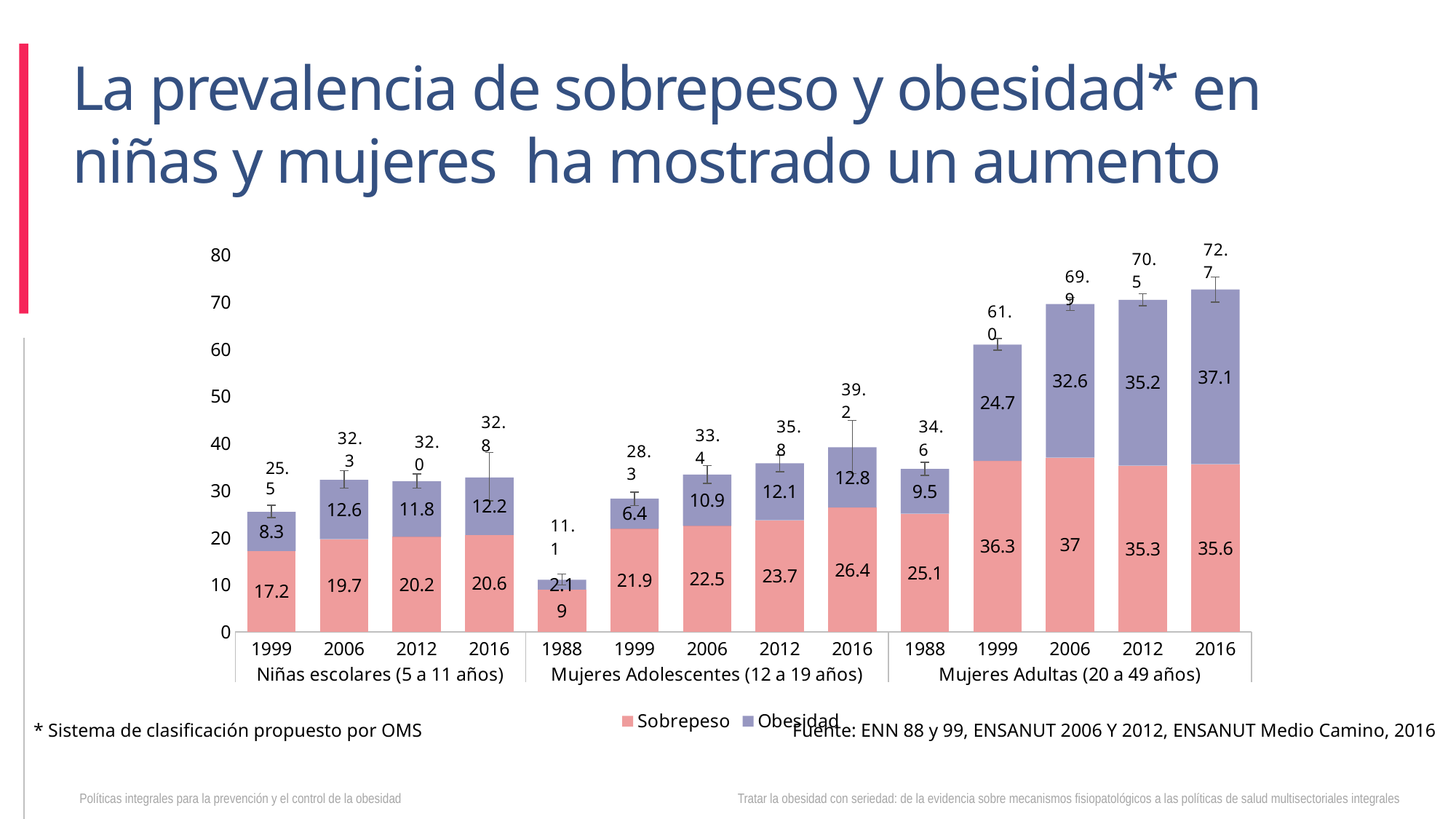
What is the Obesidad value for Niñas escolares (5 a 11 años) in 2006? 12.6 Which bar has the highest total value in the chart? 2016, Mujeres Adultas (20 a 49 años) For Mujeres Adolescentes (12 a 19 años), do the total values rise or fall from 1988 to 2016? Rise What are the two series named in the legend? Sobrepeso and Obesidad For Mujeres Adultas (20 a 49 años), what is the difference between the Obesidad value in 2016 and in 1988? 27.6 What is the total (Sobrepeso plus Obesidad) for Mujeres Adultas (20 a 49 años) in 2016? 72.7 How many stacked bars are plotted in the chart? 14 How many series does the legend list? 2 For Mujeres Adultas (20 a 49 años), which year has the larger Sobrepeso value, 2006 or 2012? 2006 What kind of chart is shown on the slide? Stacked bar chart What is the Sobrepeso value for Mujeres Adultas (20 a 49 años) in 2016? 35.6 Which bar has the lowest total value in the chart? 1988, Mujeres Adolescentes (12 a 19 años)